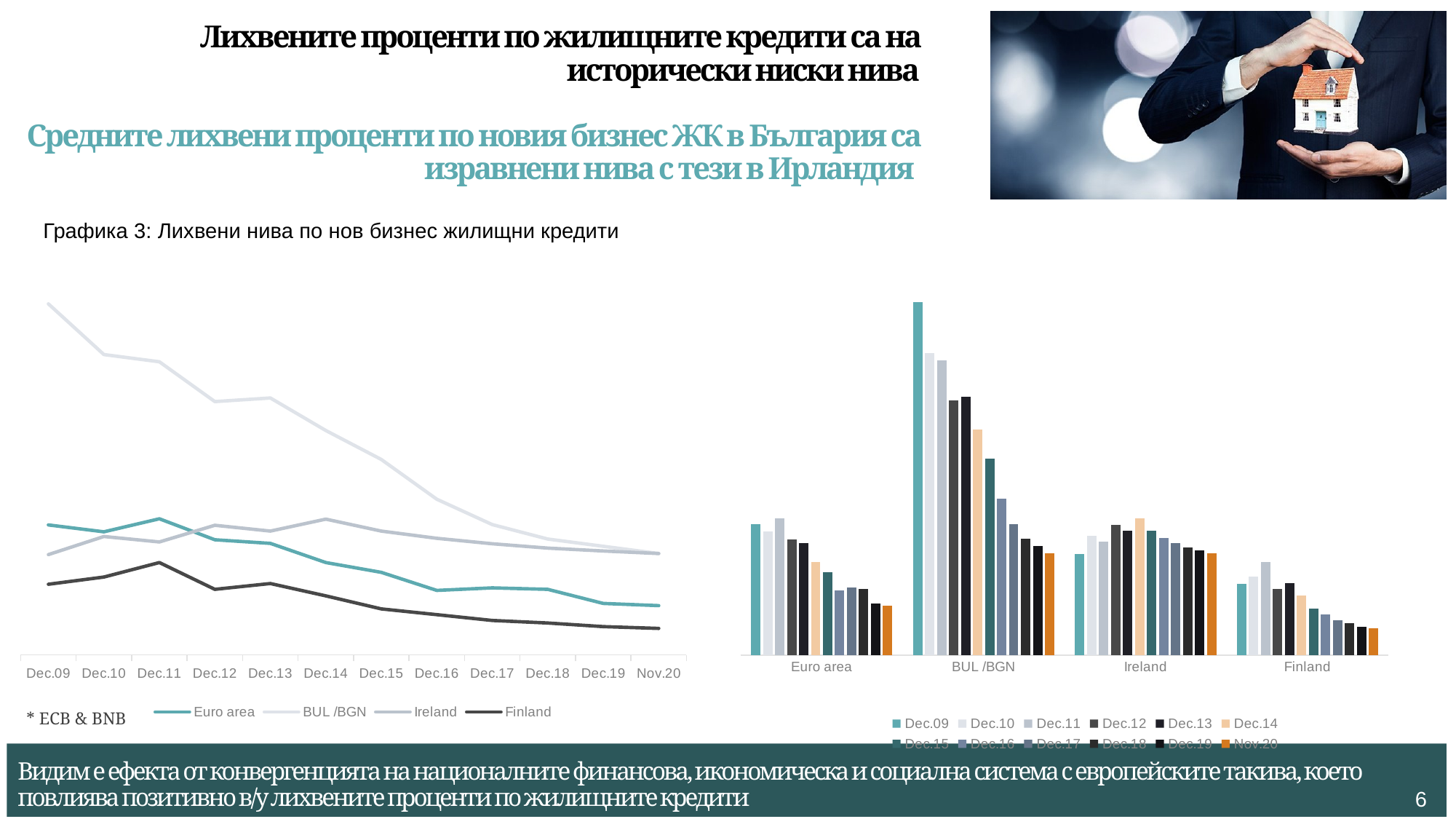
In the right bar chart, which series has the shortest bar in the BUL /BGN group? Nov.20 In the left line chart, does the BUL /BGN line rise or fall from Dec.09 to Nov.20? fall How many series does the legend of the left line chart list? 4 What kind of chart is the right chart? bar chart In the left line chart, at Nov.20 which is higher, Euro area or Ireland? Ireland How many categories are on the x axis of the right bar chart? 4 How many points are on the x axis of the left line chart? 12 In the left line chart, which series has the lowest value at Nov.20? Finland In the left line chart, which series has the highest value at Dec.09? BUL /BGN In the right bar chart, which category has the tallest bar overall? BUL /BGN How many series does the legend of the right bar chart list? 12 What kind of chart is the left chart (Графика 3)? line chart